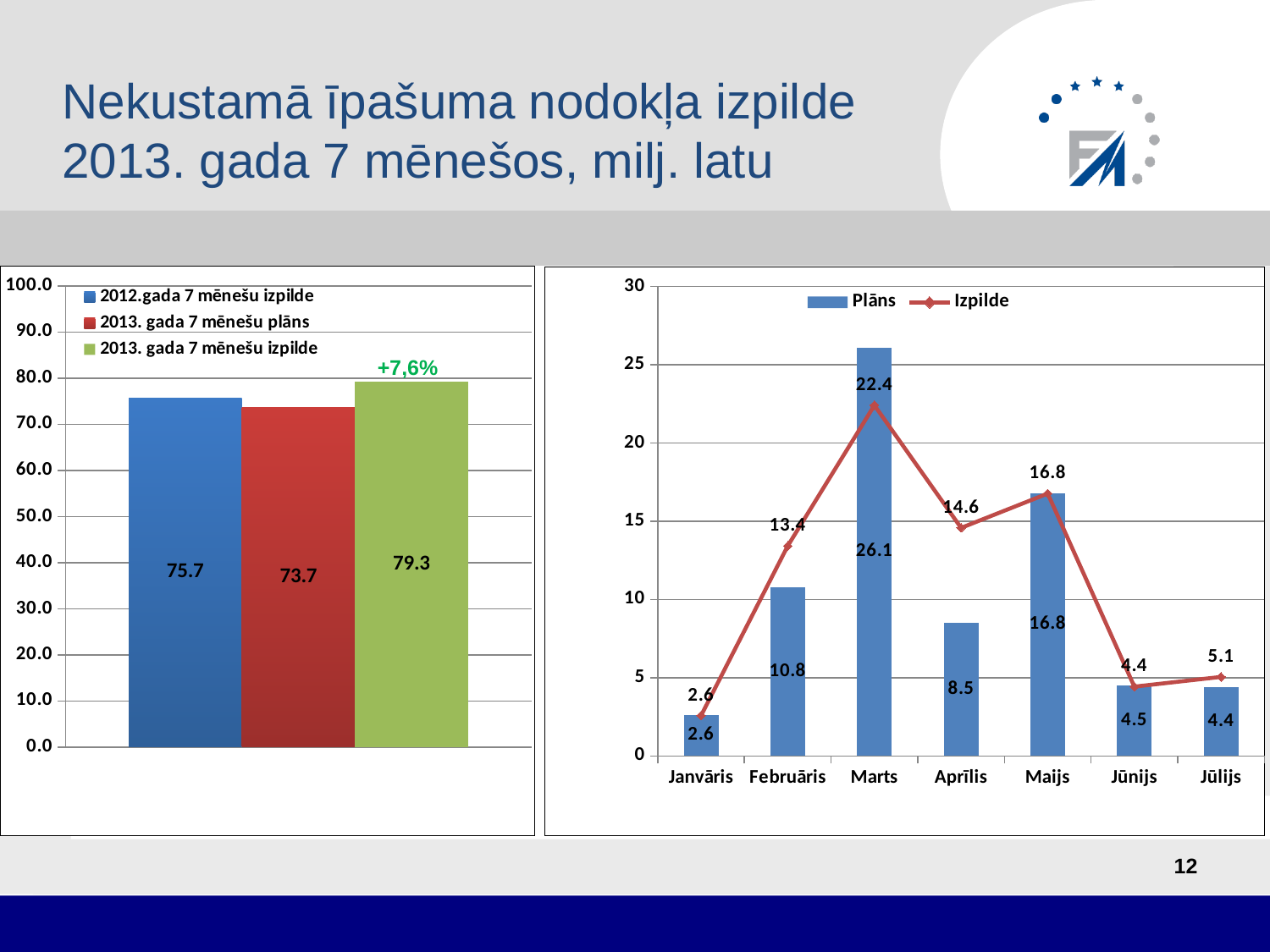
In the left chart, what is the difference between 2013. gada 7 mēnešu izpilde and 2012.gada 7 mēnešu izpilde? 3.6 In the right chart, is the Plāns value for Februāris larger or the Izpilde value for Februāris? Izpilde In the right chart, what is the difference between the Plāns and Izpilde values for Jūlijs? 0.7 In the left chart, what is the value for 2013. gada 7 mēnešu izpilde? 79.3 In the left chart, which series has the lowest value? 2013. gada 7 mēnešu plāns In the left chart, what percentage change is annotated above the green bar? +7,6% In the right chart, how many months are shown on the x axis? 7 In the left chart, what is the value for 2013. gada 7 mēnešu plāns? 73.7 In the right chart, which month has the highest Izpilde value? Marts In the right chart, what is the Plāns value for Marts? 26.1 In the left chart, how many series does the legend list? 3 In the right chart, what is the Izpilde value for Aprīlis? 14.6